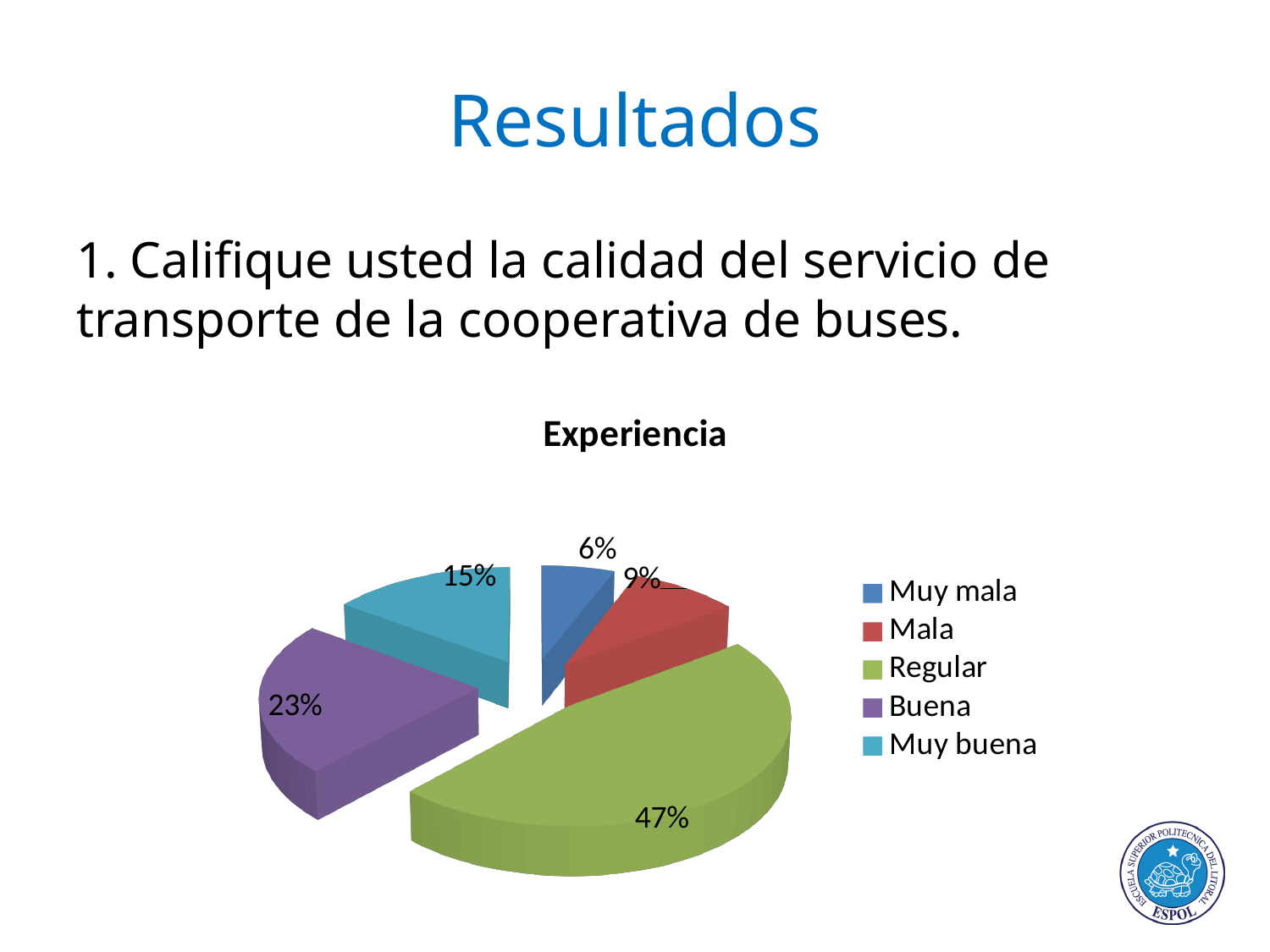
What is the difference between the shares for Regular and Buena? 24% What kind of chart is shown on the slide? pie chart What share of the pie does Muy buena have? 15% Which category has the largest slice? Regular What share of the pie does Muy mala have? 6% Which is larger, the share for Buena or the share for Muy buena? Buena Which category has the smallest slice? Muy mala How many categories does the legend list? 5 What share of the pie does Regular have? 47% What is the chart's title? Experiencia